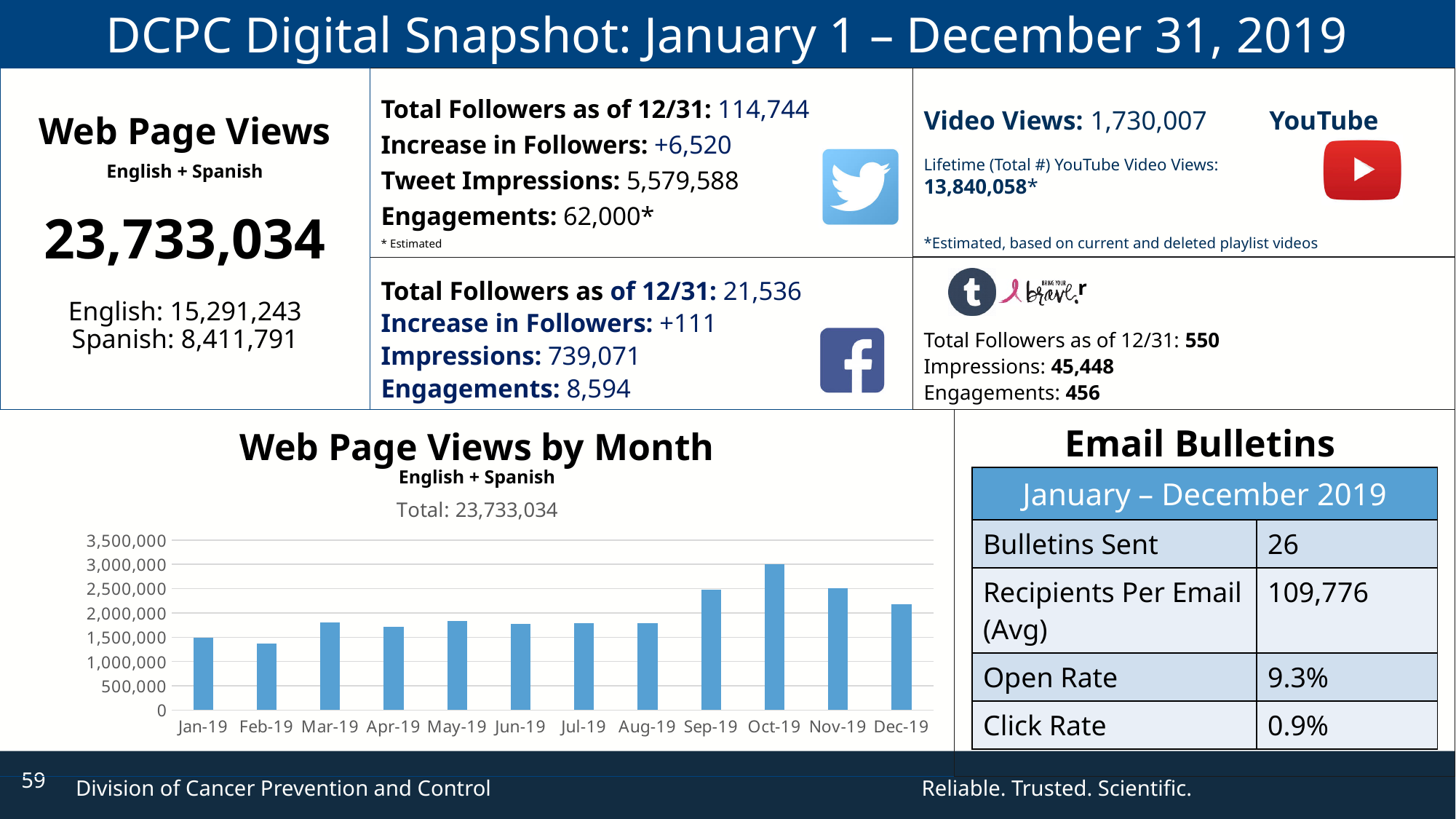
What total is printed under the title of the Web Page Views by Month chart? 23,733,034 What kind of chart is the Web Page Views by Month chart? bar chart In the Web Page Views by Month chart, which month has more web page views, Sep-19 or Dec-19? Sep-19 In the Web Page Views by Month chart, is the value for Mar-19 greater or less than 2,000,000? less In the Web Page Views by Month chart, which month has more web page views, Oct-19 or Nov-19? Oct-19 In the Web Page Views by Month chart, is the value for Feb-19 greater or less than 1,500,000? less How many months are shown on the x axis of the Web Page Views by Month chart? 12 Which month has the highest web page views in the Web Page Views by Month chart? Oct-19 Which month has the lowest web page views in the Web Page Views by Month chart? Feb-19 In the Web Page Views by Month chart, is the value for Dec-19 greater or less than 2,000,000? greater What subtitle appears directly below the title of the Web Page Views by Month chart? English + Spanish